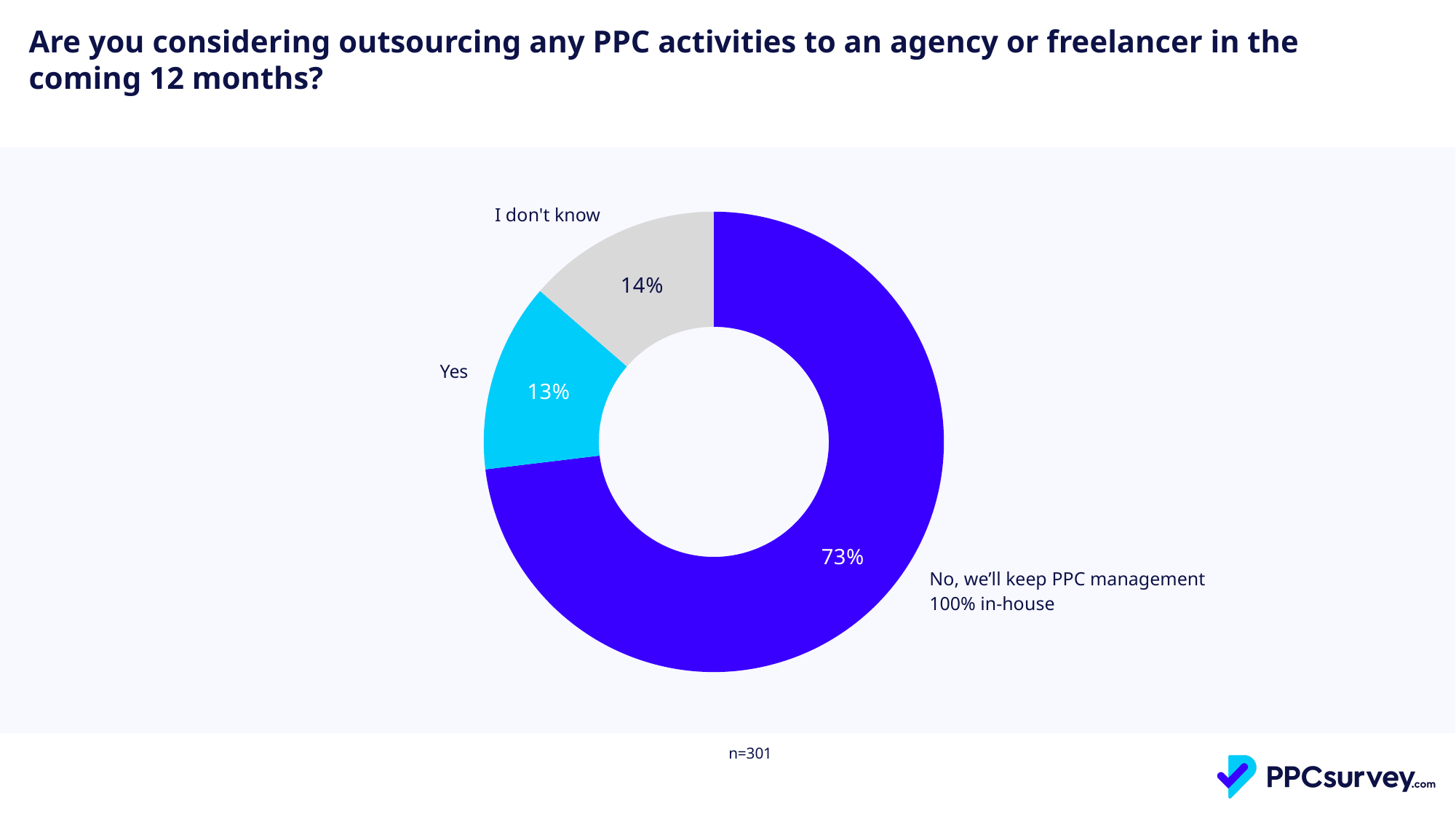
What percentage of respondents answered "No, we'll keep PPC management 100% in-house"? 73% What percentage of respondents answered "Yes"? 13% What colour is the "Yes" segment of the chart? Cyan (light blue) How many response categories are shown in the chart? 3 What is the sample size (n) shown on the slide? n=301 Which response has the smallest share of the chart? Yes What percentage of respondents answered "I don't know"? 14% What is the difference in percentage points between the "No, we'll keep PPC management 100% in-house" share and the "Yes" share? 60 What kind of chart is shown on the slide? Pie chart (donut) What is the difference in percentage points between "I don't know" and "Yes"? 1 Which response has the largest share of the chart? No, we'll keep PPC management 100% in-house Which is larger: the share for "Yes" or the share for "I don't know"? I don't know